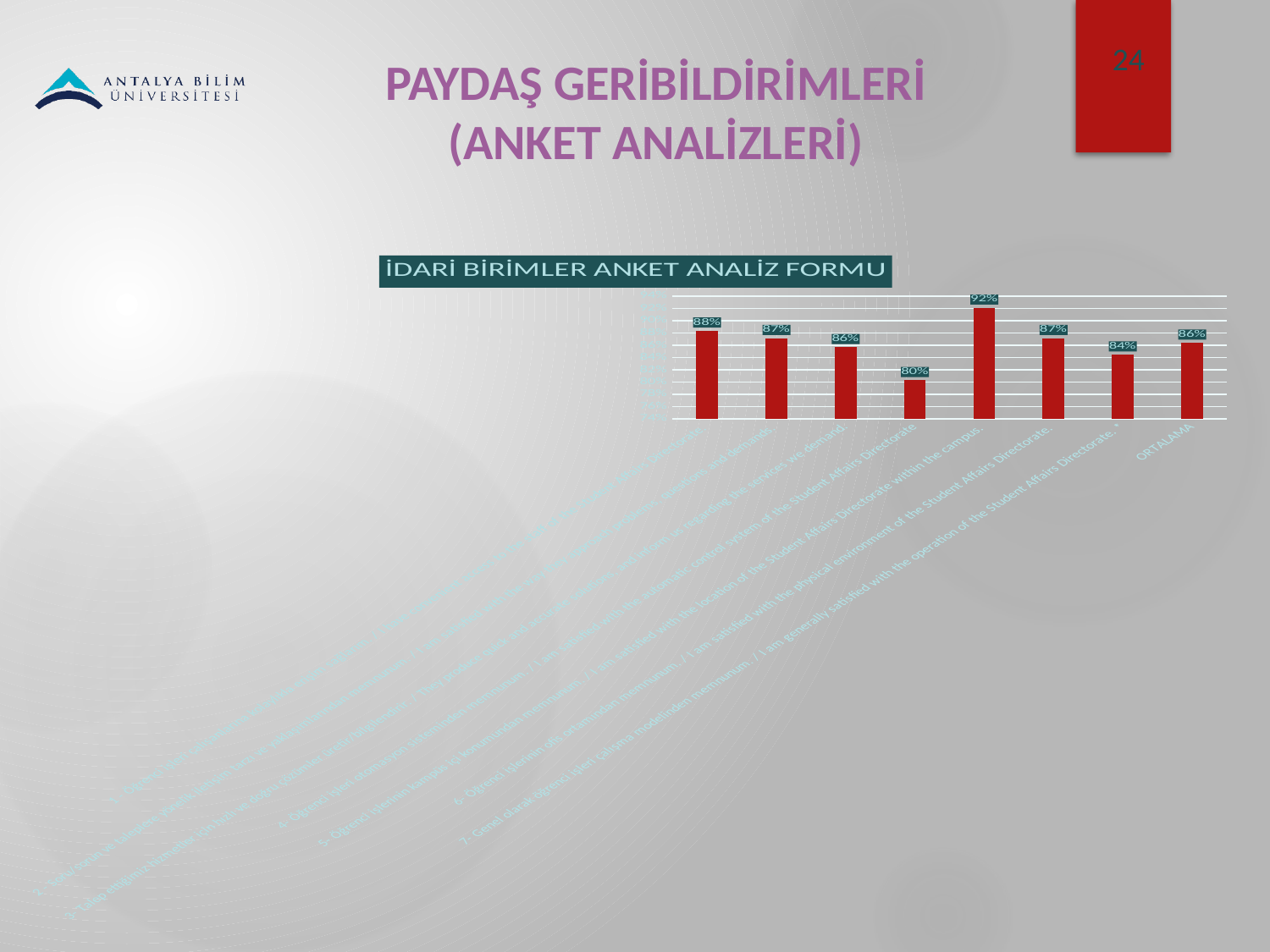
What is the difference between the highest and lowest values in the chart? 12 percentage points What is the value of the ORTALAMA bar? 86% What is the title of the chart on the slide? İDARİ BİRİMLER ANKET ANALİZ FORMU What is the value of the fourth bar from the left? 80% How many bars are plotted in the chart? 8 Which is larger: the first bar or the ORTALAMA bar? The first bar By how much does the first bar exceed the ORTALAMA bar? 2 percentage points What colour are the bars in the chart? Red What is the highest value shown in the chart? 92% What is the lowest value shown in the chart? 80% What is the value of the first (leftmost) bar in the chart? 88% What kind of chart is shown on the slide? Bar chart